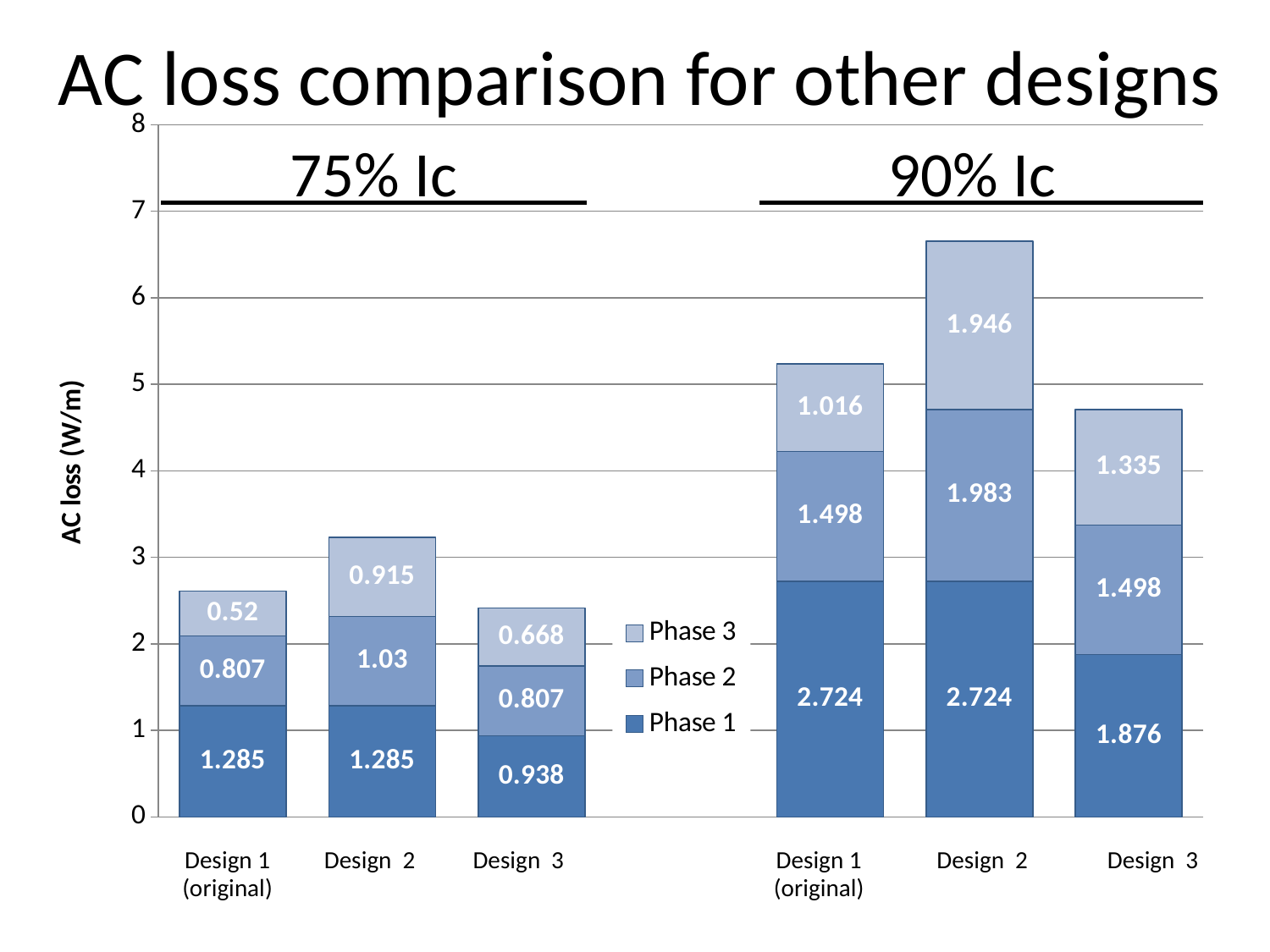
How many series does the legend list? 3 What is the total AC loss for Design 1 (original) at 90% Ic? 5.238 What is the Phase 3 value for Design 2 at 90% Ic? 1.946 What type of chart is shown? Stacked bar chart What is the Phase 1 value for Design 3 at 90% Ic? 1.876 Which bar has the highest total AC loss? Design 2 at 90% Ic Which bar has the lowest total AC loss? Design 3 at 75% Ic Is the Phase 3 value larger for Design 2 or Design 3 at 75% Ic? Design 2 What is the total AC loss for Design 2 at 75% Ic? 3.23 What is the difference between the Phase 2 values of Design 2 and Design 1 (original) at 90% Ic? 0.485 What is the Phase 1 value for Design 1 (original) at 75% Ic? 1.285 What is the Phase 2 value for Design 3 at 75% Ic? 0.807